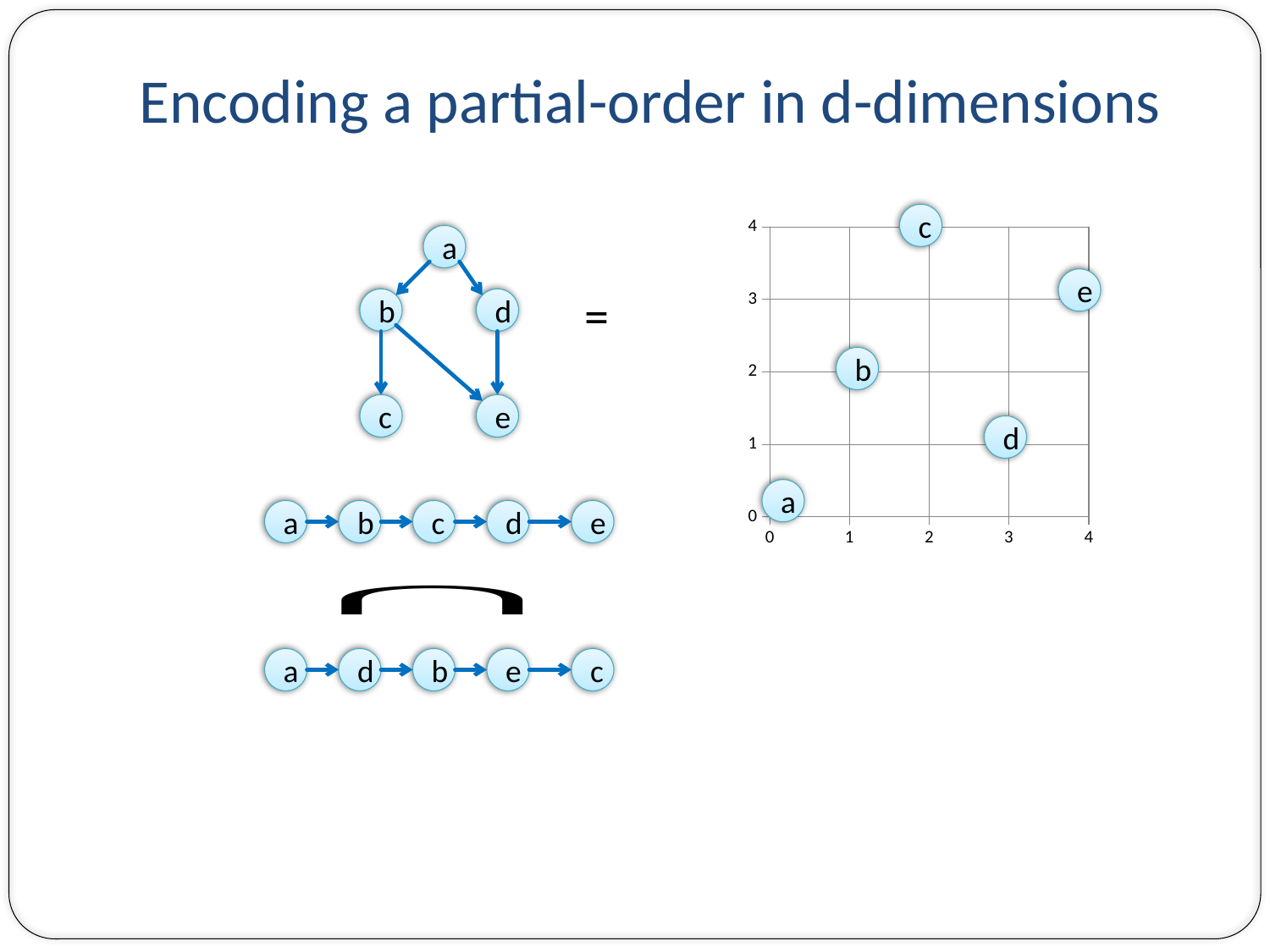
In the chart on the right, what is the highest value shown on the x axis? 4 In the chart on the right, what is the y-axis value of point c? 4 In the chart on the right, is the y-axis value of point e greater or less than 2? greater In the chart on the right, how many points are plotted? 5 In the chart on the right, what is the x-axis value of point d? 3 In the chart on the right, which point has a higher y-axis value, b or d? b In the chart on the right, what is the difference between the y-axis values of c and d? 3 What kind of chart is shown on the right of the slide? scatter chart In the chart on the right, which point has the highest y-axis value? c In the chart on the right, what is the x-axis value of point e? 4 In the chart on the right, what is the y-axis value of point b? 2 In the chart on the right, which point has the lowest y-axis value? a